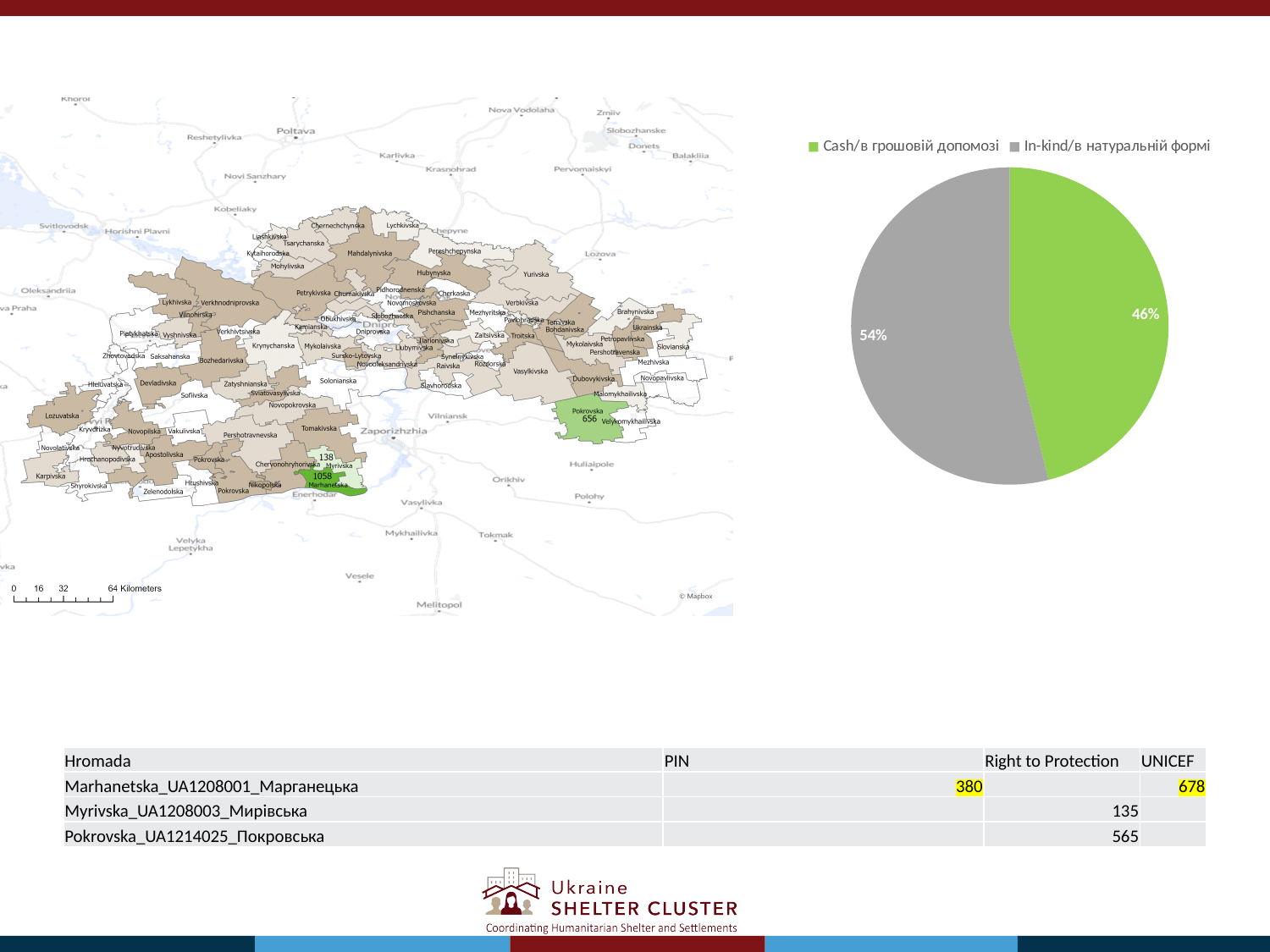
In the pie chart, what is the difference in percentage points between the In-kind and Cash slices? 8 percentage points What type of chart is shown on the right side of the slide? pie chart On the map, what value is labelled for the Marhanetska hromada? 1058 In the pie chart, what colour is the Cash/в грошовій допомозі slice? green In the pie chart, what share is shown for In-kind/в натуральній формі? 54% In the pie chart, is the share for Cash/в грошовій допомозі greater or less than 50%? less In the pie chart, which category has the larger slice? In-kind/в натуральній формі In the pie chart, which category has the smaller slice? Cash/в грошовій допомозі In the pie chart, is the Cash slice larger or smaller than the In-kind slice? smaller How many slices does the pie chart have? 2 In the pie chart, what share is shown for Cash/в грошовій допомозі? 46% How many entries does the pie chart's legend list? 2